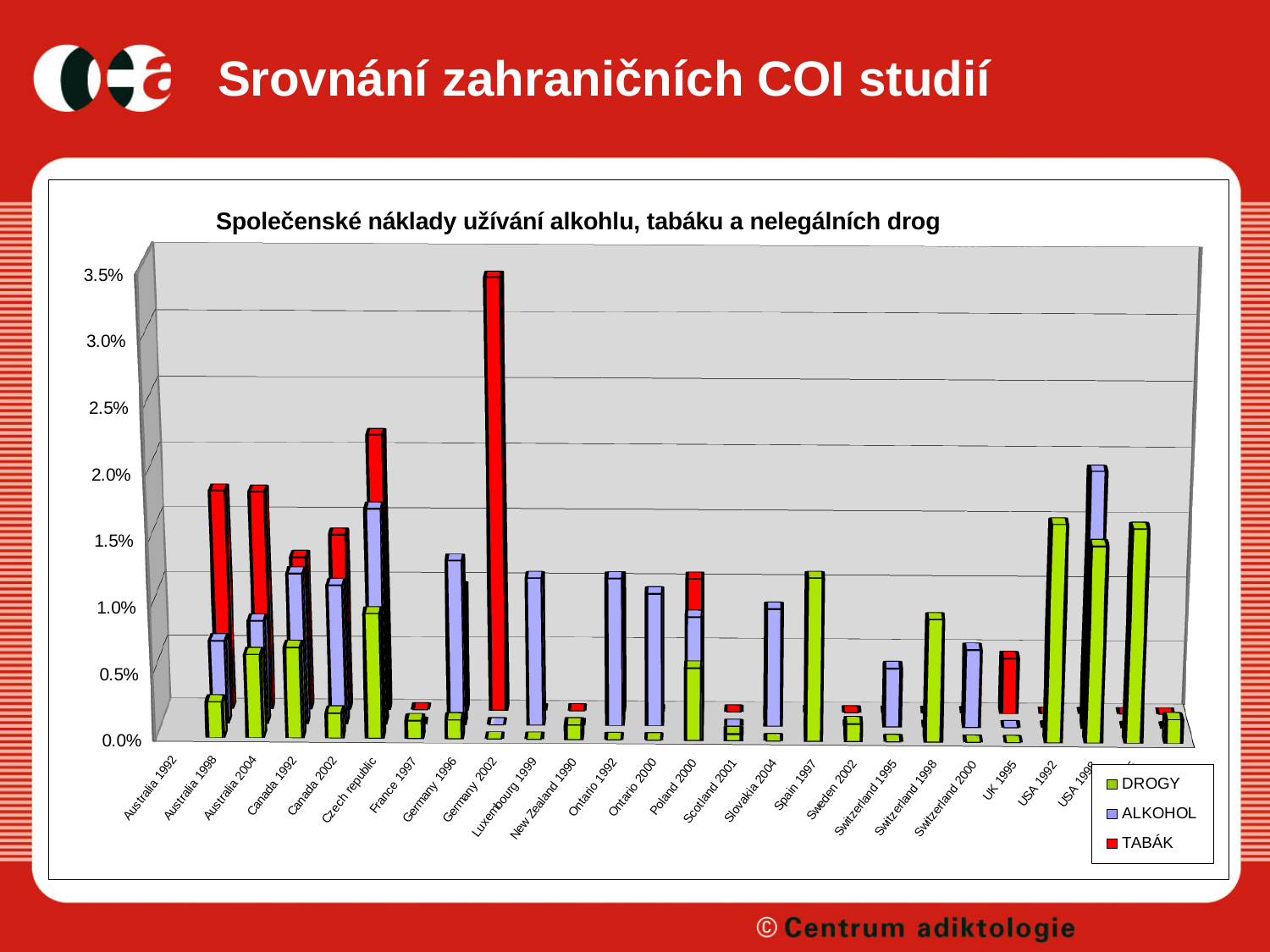
Is the ALKOHOL value for Luxembourg 1999 greater or less than 1.0%? greater What are the three series named in the legend? DROGY, ALKOHOL, TABÁK Is the TABÁK value for Germany 2002 greater or less than 3.0%? greater Which is larger, the TABÁK value for Germany 2002 or the TABÁK value for Czech republic? Germany 2002 Is the TABÁK value for France 1997 greater or less than 0.5%? less What kind of chart is shown on the slide? bar chart Which category has the highest TABÁK value? Germany 2002 Which is larger, the DROGY value for Spain 1997 or the DROGY value for Sweden 2002? Spain 1997 How many series does the legend list? 3 What is the title of the chart? Společenské náklady užívání alkohlu, tabáku a nelegálních drog